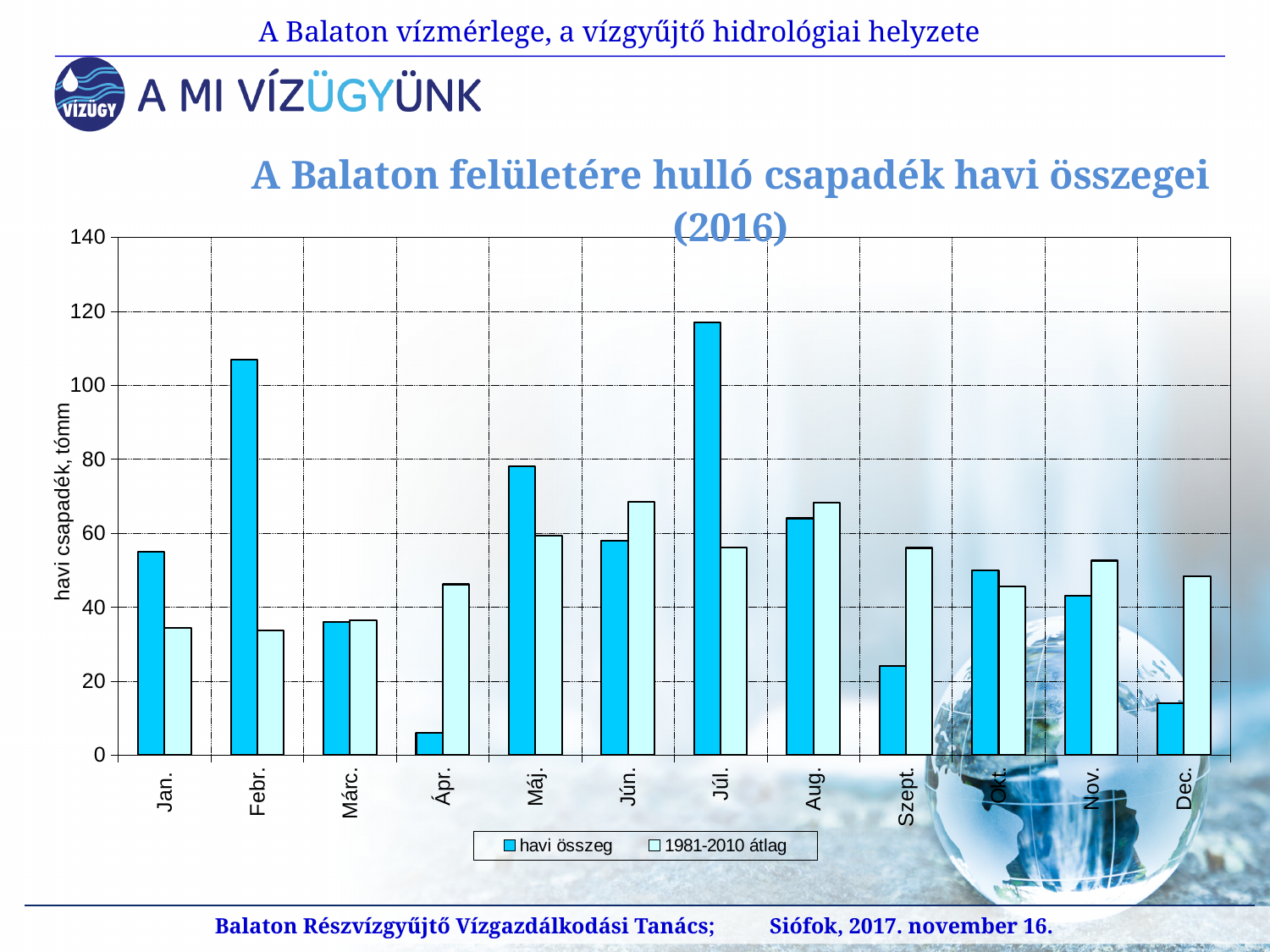
Which month has the highest 'havi összeg' value? Júl. What kind of chart is shown on the slide? bar chart Is the '1981-2010 átlag' value for Jún. greater or less than 60? greater How many series does the chart's legend list? 2 Is the 'havi összeg' value for Júl. greater or less than 100? greater For Szept., which is larger: the 'havi összeg' or the '1981-2010 átlag'? 1981-2010 átlag Is the 'havi összeg' value for Ápr. greater or less than 20? less What is the label of the chart's vertical axis? havi csapadék, tómm How many months (categories) are shown on the x axis of the chart? 12 For Febr., which is larger: the 'havi összeg' or the '1981-2010 átlag'? havi összeg Which month has the lowest 'havi összeg' value? Ápr.